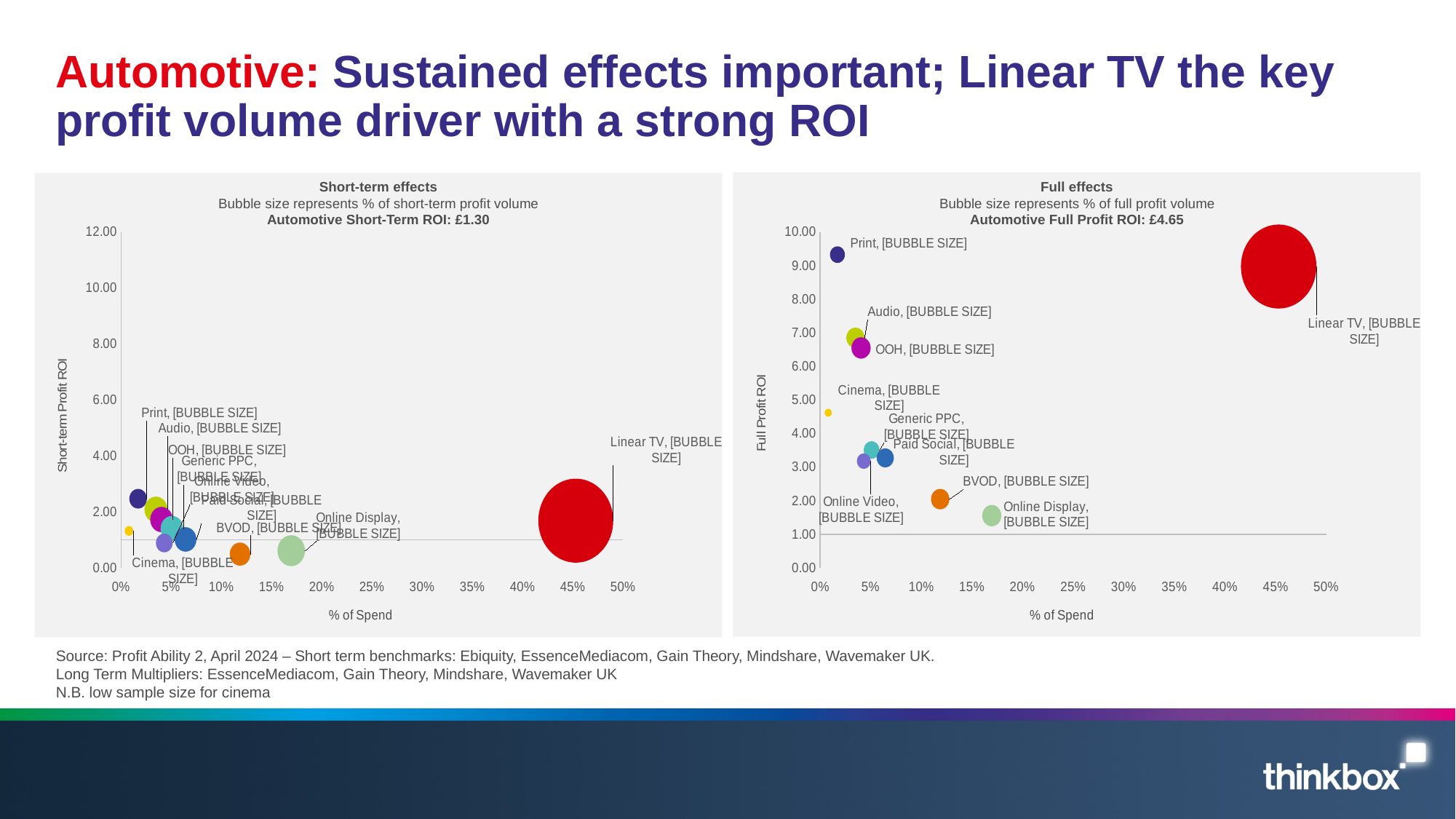
In the 'Short-term effects' chart, which has the higher Short-term Profit ROI: Print or Online Display? Print In the 'Short-term effects' chart, is the % of Spend for Linear TV greater or less than 40%? greater In the 'Full effects' chart, which media channel has the largest bubble? Linear TV In the 'Short-term effects' chart, which media channel has the highest % of Spend? Linear TV In the 'Short-term effects' chart, what is the Automotive Short-Term ROI stated in the chart title? £1.30 In the 'Full effects' chart, is the Full Profit ROI for Online Display greater or less than 2.00? less How many media channels are plotted in the 'Full effects' chart? 10 In the 'Full effects' chart, is the Full Profit ROI for Linear TV greater or less than 8.00? greater What type of chart is used on the left-hand 'Short-term effects' panel? Bubble chart In the 'Full effects' chart, what is the Automotive Full Profit ROI stated in the chart title? £4.65 In the 'Full effects' chart, which has the higher Full Profit ROI: OOH or BVOD? OOH